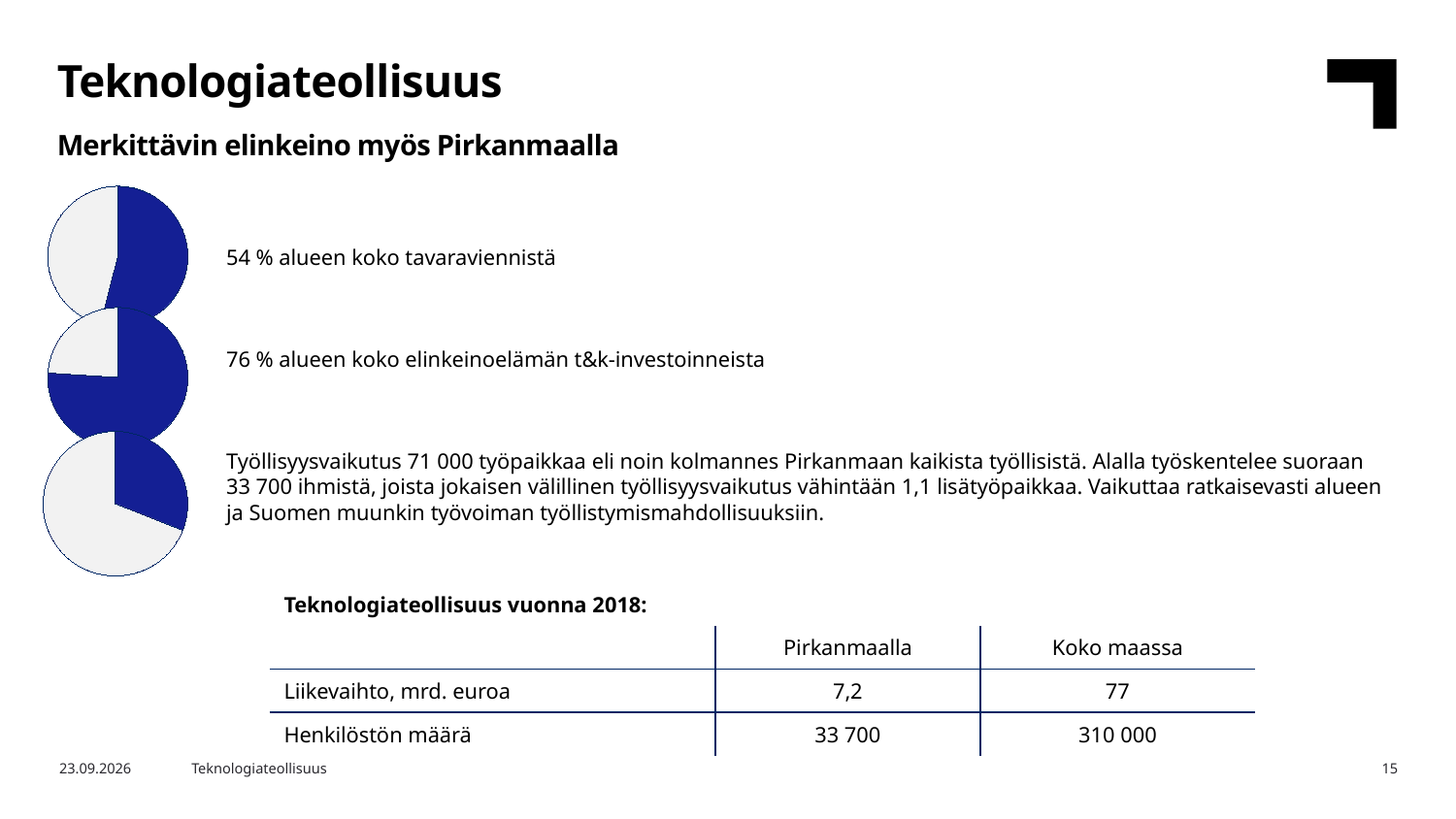
Which pie chart has the larger blue slice, the top one (tavaravienti) or the middle one (t&k-investoinnit)? The middle one (t&k-investoinnit) In the top pie chart, what share of the region's total goods exports does the blue slice represent? 54 % What colour is the highlighted slice in each pie chart? Blue How many slices does each pie chart have? 2 Is the blue slice in the bottom pie chart (työllisyysvaikutus) greater or less than 50 %? less Which of the three pie charts has the smallest blue slice? The bottom one (työllisyysvaikutus) Is the blue slice in the top pie chart greater or less than 50 %? greater How many pie charts are on the slide? 3 What kind of charts are shown on the left side of the slide? Pie charts In the middle pie chart, what share of the region's business R&D investments does the blue slice represent? 76 % Which of the three pie charts has the largest blue slice? The middle one (t&k-investoinnit) Is the blue slice in the middle pie chart greater or less than 50 %? greater